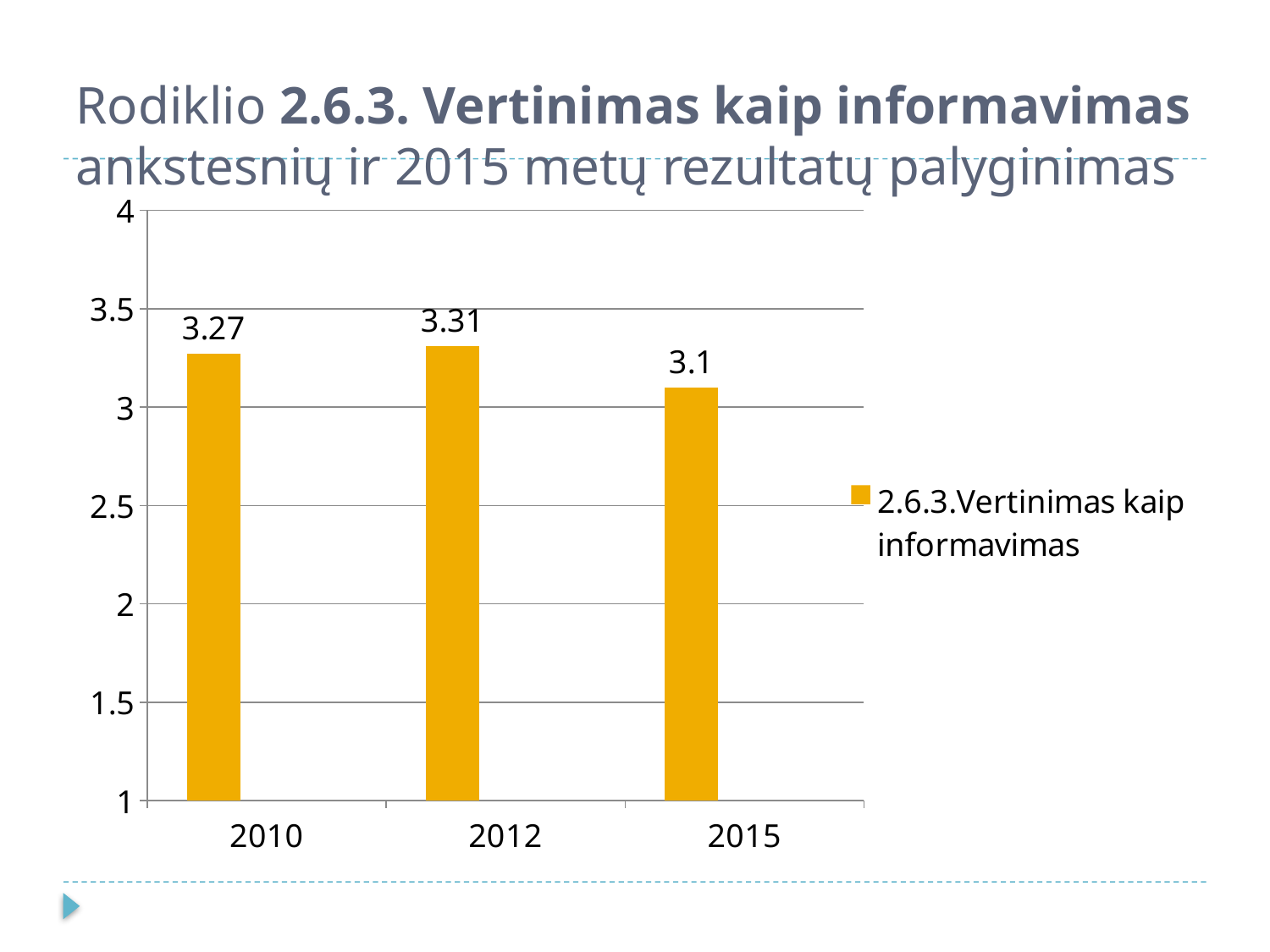
Which is larger, the value for 2010 or the value for 2015? 2010 What kind of chart is shown on the slide? bar chart What is the value for 2015? 3.1 How many years are shown on the x axis? 3 Is the value for 2015 greater or less than 3.5? less Which year has the lowest value? 2015 What is the difference between the values for 2010 and 2015? 0.17 What is the difference between the values for 2012 and 2015? 0.21 What is the value for 2010? 3.27 Which year has the highest value? 2012 What series name does the legend show? 2.6.3.Vertinimas kaip informavimas What is the value for 2012? 3.31